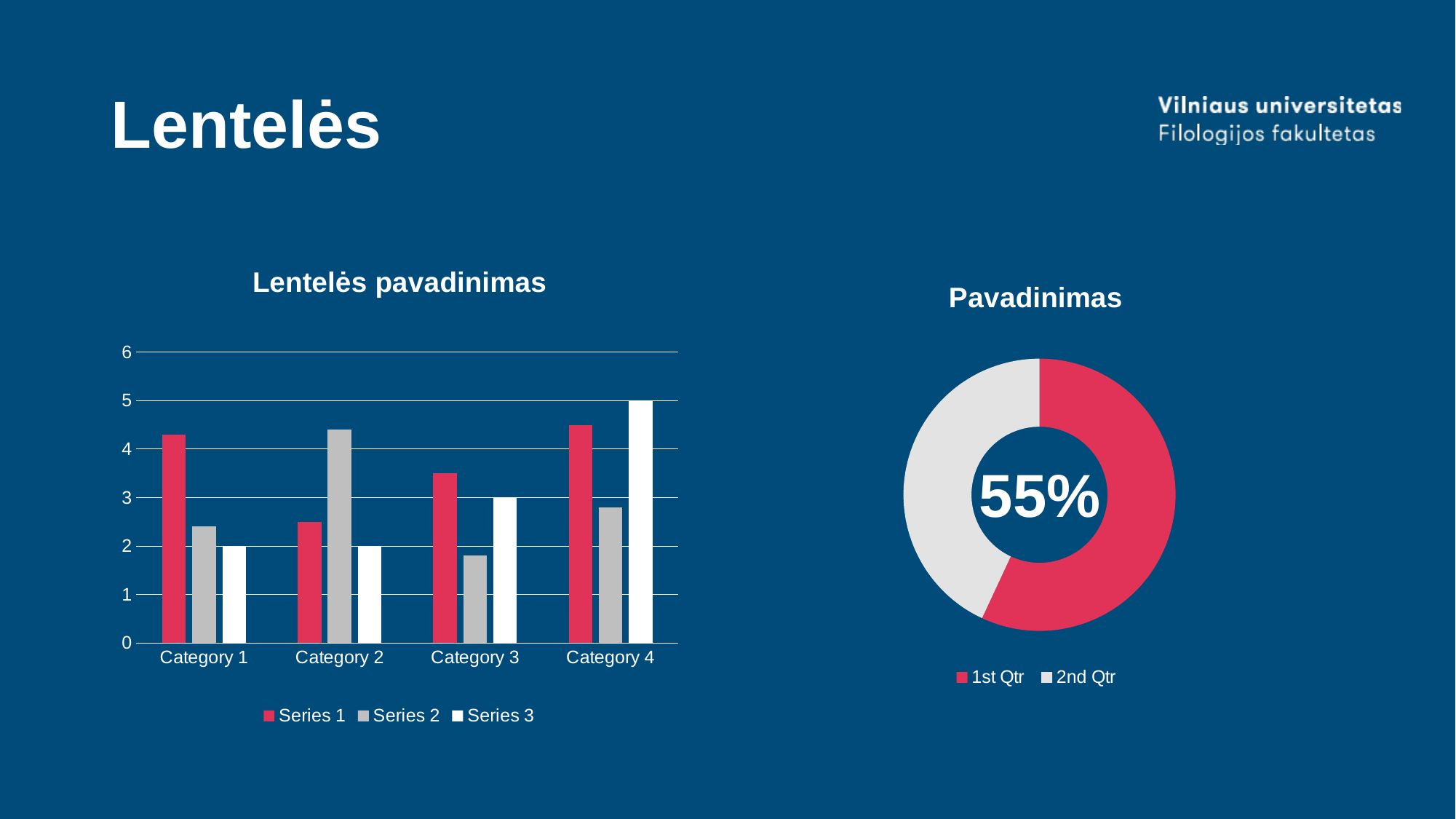
In the chart titled "Lentelės pavadinimas", which category has the highest value for Series 3? Category 4 In the chart titled "Lentelės pavadinimas", for Category 2, which is larger: Series 1 or Series 2? Series 2 In the chart titled "Lentelės pavadinimas", is the value of Series 2 for Category 3 greater or less than 2? less In the chart titled "Lentelės pavadinimas", how many series does the legend list? 3 In the chart titled "Lentelės pavadinimas", what is the value of Series 3 for Category 4? 5 In the chart titled "Lentelės pavadinimas", is the value of Series 1 for Category 1 greater or less than 4? greater In the chart titled "Lentelės pavadinimas", how many categories are shown on the x axis? 4 In the chart titled "Lentelės pavadinimas", which category has the highest value for Series 2? Category 2 What kind of chart is the chart titled "Lentelės pavadinimas"? Bar chart In the chart titled "Pavadinimas", what percentage is printed in the centre of the doughnut? 55% In the chart titled "Lentelės pavadinimas", what is the value of Series 3 for Category 3? 3 In the chart titled "Pavadinimas", how many entries does the legend list? 2